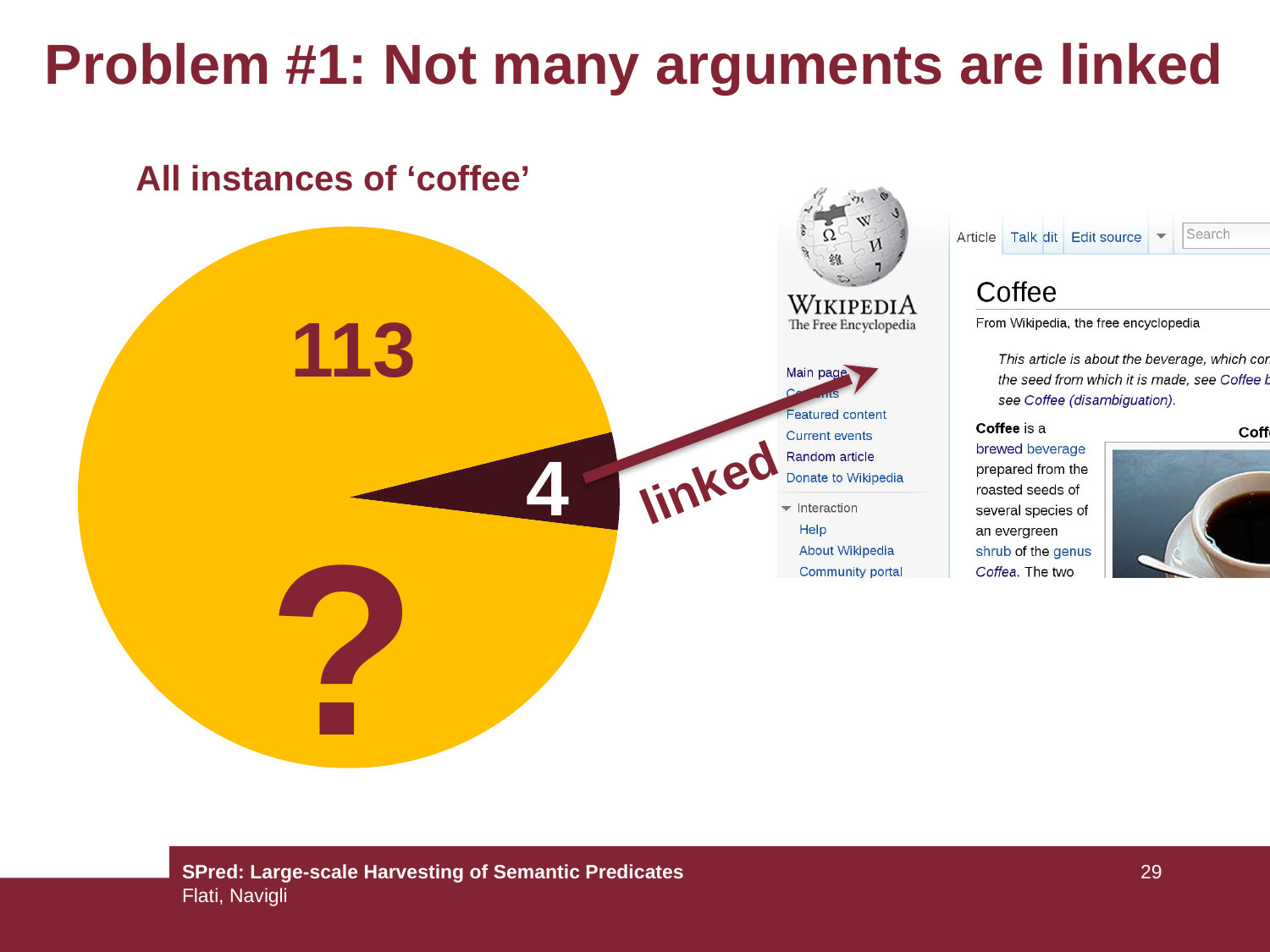
Is the value of the 'linked' slice greater or less than 10? less Which slice of the pie chart is the smallest? the 'linked' slice (4) Which slice of the pie chart is the largest? the yellow slice (113) What value is printed on the large yellow slice of the pie chart? 113 What is the total number of instances of 'coffee' represented in the pie chart? 117 What label is written next to the small dark red slice of the pie chart? linked What is the title of the pie chart? All instances of 'coffee' What kind of chart is shown on the slide? pie chart What value is printed on the small dark red slice labelled 'linked'? 4 How many slices does the pie chart have? 2 What is the difference between the value of the yellow slice and the 'linked' slice? 109 Which is larger: the number of linked instances or the number of unlinked instances of 'coffee'? unlinked (113)